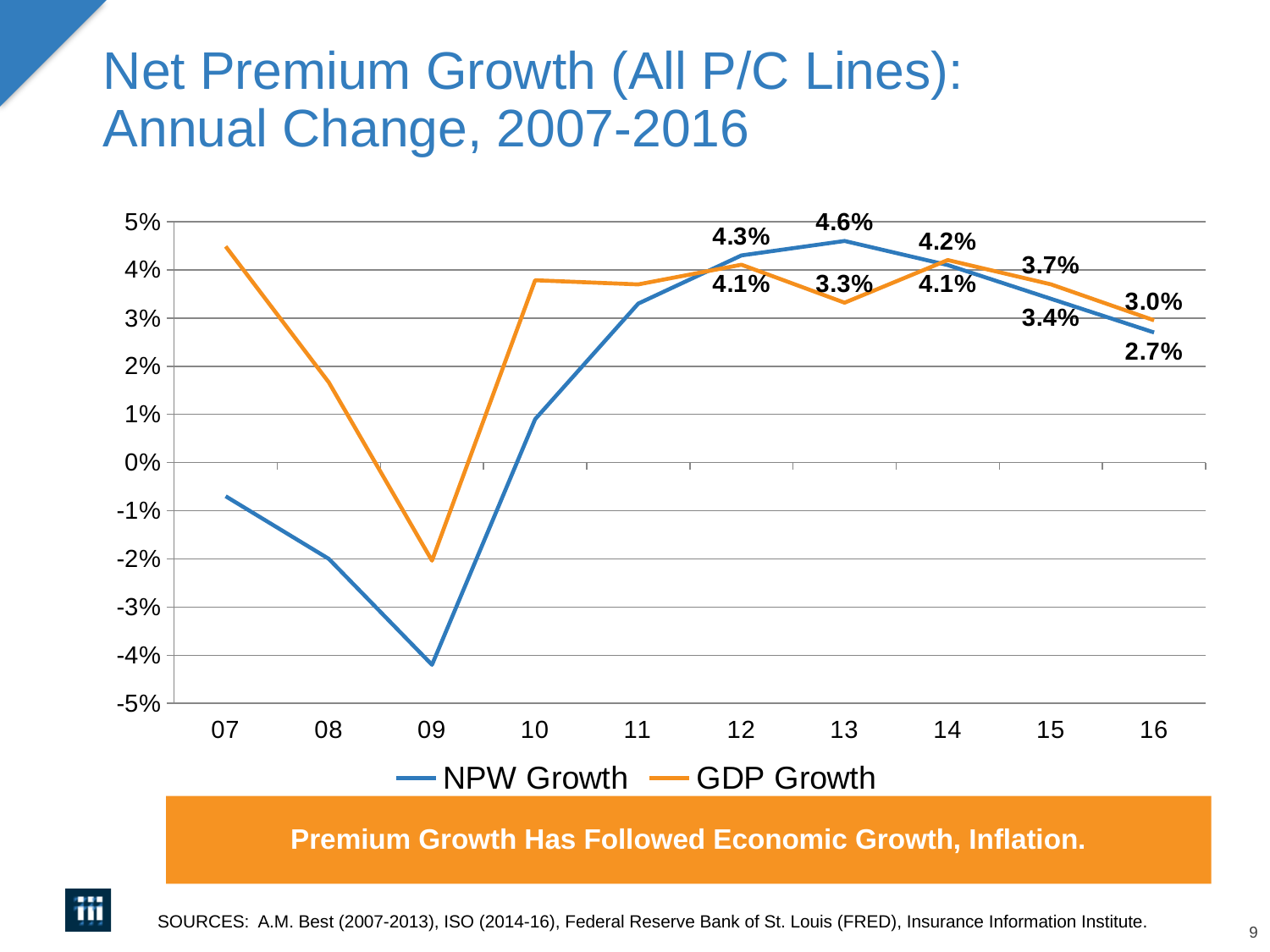
What is the difference between NPW Growth and GDP Growth in 2013? 1.3 percentage points What is the GDP Growth value for 2016? 3.0% Is the NPW Growth value for 2009 greater or less than -3%? less What is the NPW Growth value for 2016? 2.7% What is the GDP Growth value for 2013? 3.3% What is the NPW Growth value for 2013? 4.6% Does NPW Growth rise or fall from 2013 to 2016? Fall What type of chart is shown on the slide? Line chart How many series does the legend list? 2 In which year is NPW Growth at its lowest? 09 How many years are plotted along the x axis? 10 In 2012, which series has the higher value, NPW Growth or GDP Growth? NPW Growth